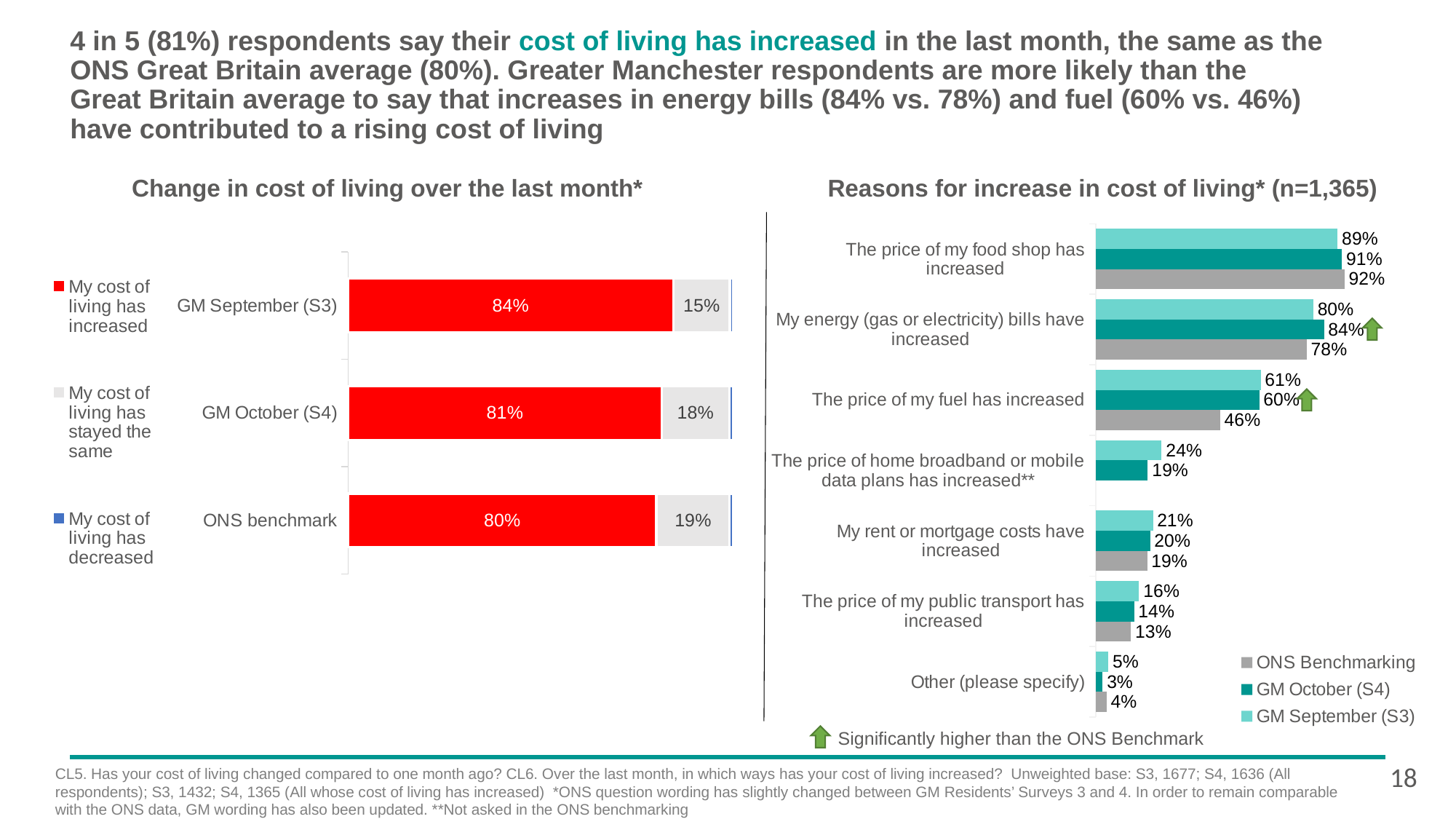
In the 'Reasons for increase in cost of living' chart, what is the difference between the GM September (S3) and GM October (S4) values for 'The price of home broadband or mobile data plans has increased'? 5 percentage points How many reasons are listed in the 'Reasons for increase in cost of living' chart? 7 In the 'Reasons for increase in cost of living' chart, what is the ONS Benchmarking value for 'The price of my fuel has increased'? 46% In the 'Change in cost of living over the last month' chart, which category has the highest share saying their cost of living has increased? GM September (S3) In the 'Change in cost of living over the last month' chart, what percentage of GM September (S3) respondents say their cost of living has stayed the same? 15% In the 'Change in cost of living over the last month' chart, what is the difference between the GM September (S3) and ONS benchmark shares saying their cost of living has increased? 4 percentage points In the 'Reasons for increase in cost of living' chart, which reason has the highest GM October (S4) value? The price of my food shop has increased In the 'Change in cost of living over the last month' chart, what percentage of GM October (S4) respondents say their cost of living has increased? 81% In the 'Reasons for increase in cost of living' chart, which reason has the lowest GM September (S3) value? Other (please specify) How many series does the legend of the 'Reasons for increase in cost of living' chart list? 3 In the 'Reasons for increase in cost of living' chart, is the GM October (S4) value for 'The price of my fuel has increased' larger or smaller than the ONS Benchmarking value? larger In the 'Reasons for increase in cost of living' chart, what is the GM October (S4) value for 'My energy (gas or electricity) bills have increased'? 84%